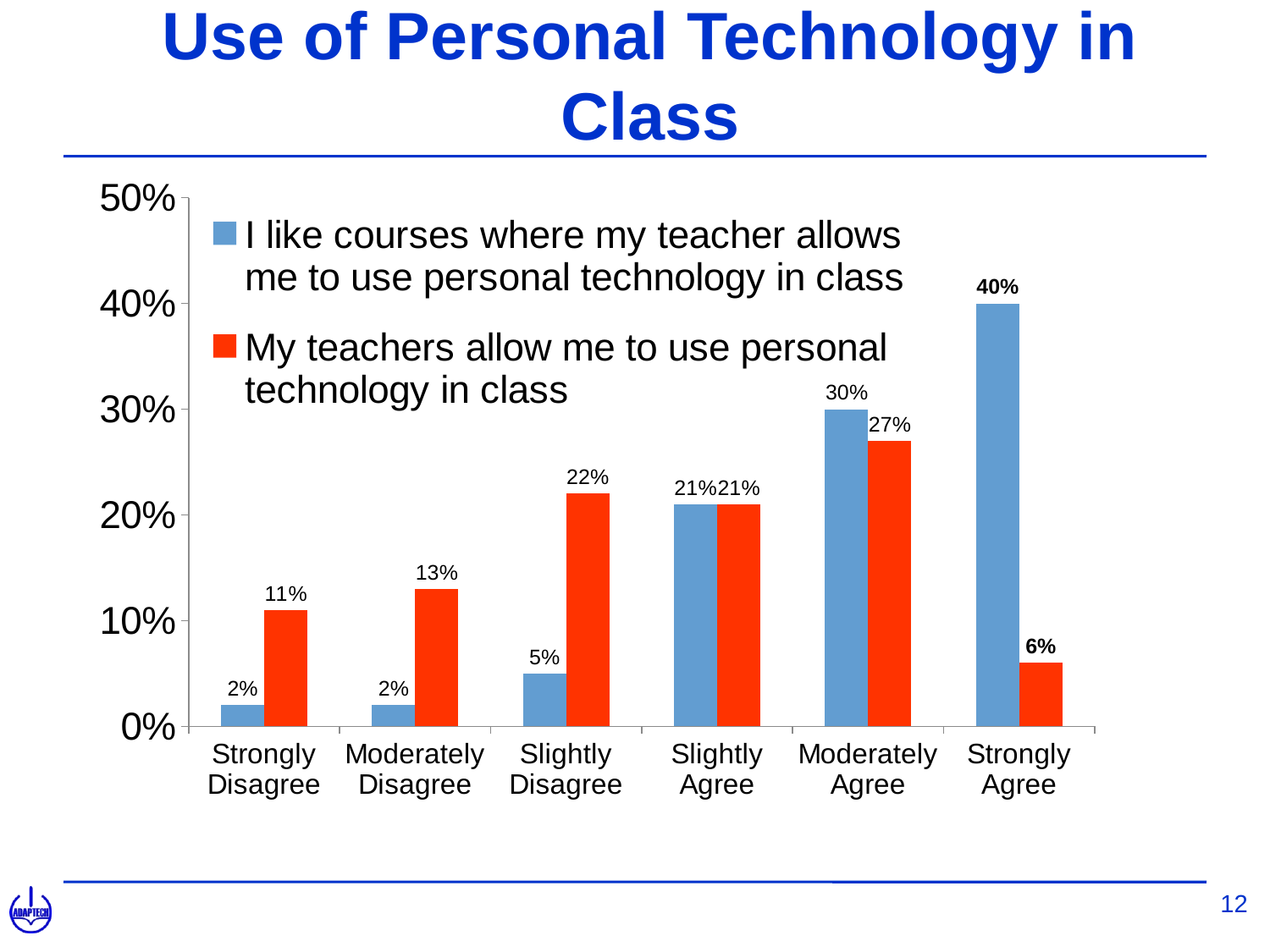
How many response categories are shown on the x axis? 6 What is the title of the slide? Use of Personal Technology in Class Which category has the lowest value for "My teachers allow me to use personal technology in class"? Strongly Agree What kind of chart is shown on the slide? Bar chart What percentage of respondents Strongly Agree with "My teachers allow me to use personal technology in class"? 6% Do the values for "I like courses where my teacher allows me to use personal technology in class" rise or fall from Strongly Disagree to Strongly Agree? Rise For Moderately Disagree, which series has the larger value? My teachers allow me to use personal technology in class How many series does the legend list? 2 What percentage of respondents Strongly Agree with "I like courses where my teacher allows me to use personal technology in class"? 40% What is the difference between the two series for the Strongly Agree category? 34% What is the value for Slightly Disagree in the "My teachers allow me to use personal technology in class" series? 22% Which category has the highest value for "I like courses where my teacher allows me to use personal technology in class"? Strongly Agree